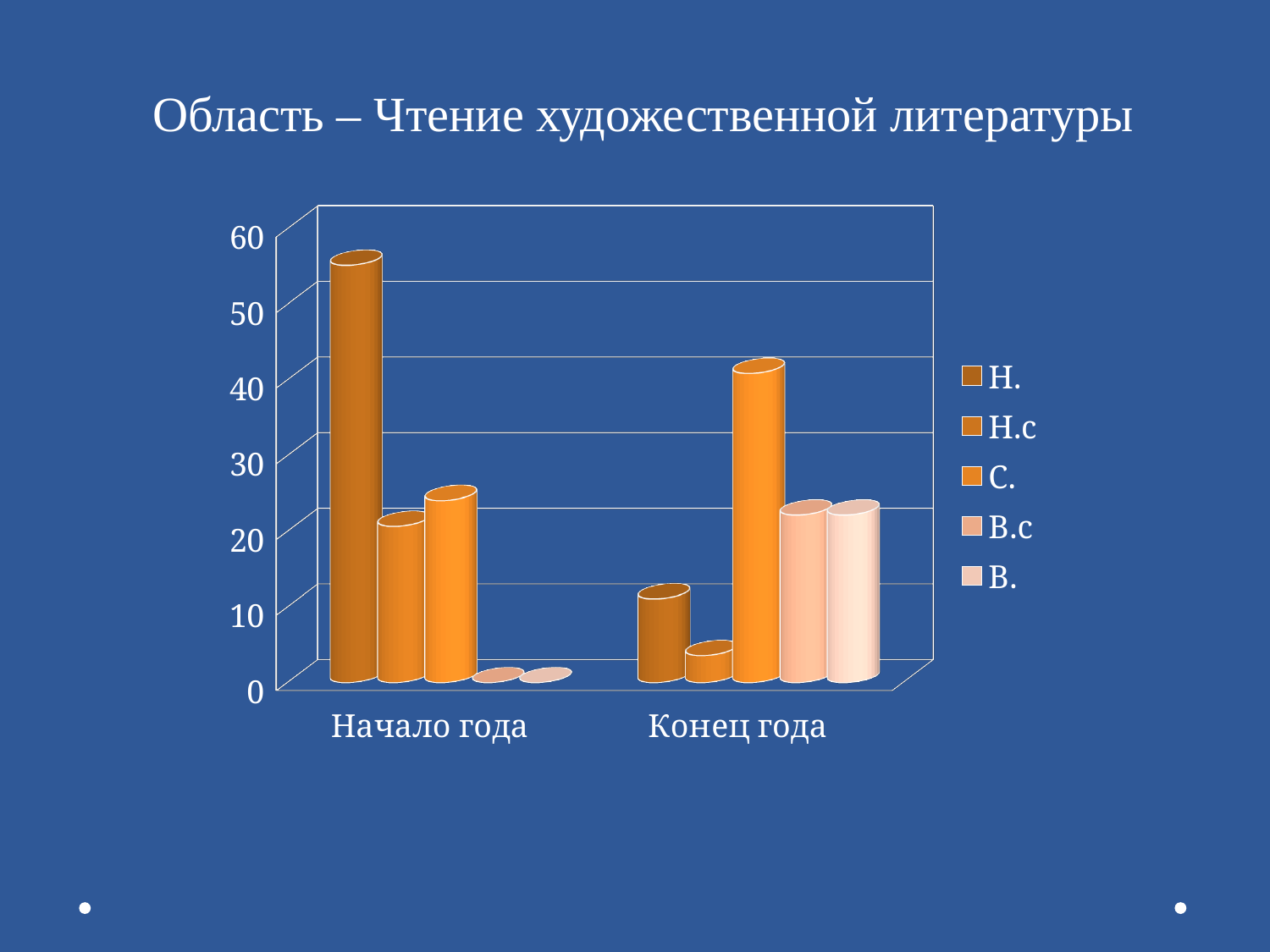
What kind of chart is shown on the slide? bar chart Which is larger: the value for Н. in Начало года or the value for Н. in Конец года? Начало года Does the value for С. rise or fall from Начало года to Конец года? rise Is the value for Н. in Конец года greater or less than 20? less How many series does the legend list? 5 What is the title of the slide? Область – Чтение художественной литературы Which series has the highest value for Конец года? С. Is the value for С. in Конец года greater or less than 30? greater How many categories are shown on the x axis? 2 Is the value for Н. in Начало года greater or less than 50? greater Which series has the lowest value for Конец года? Н.с Which series has the highest value for Начало года? Н.